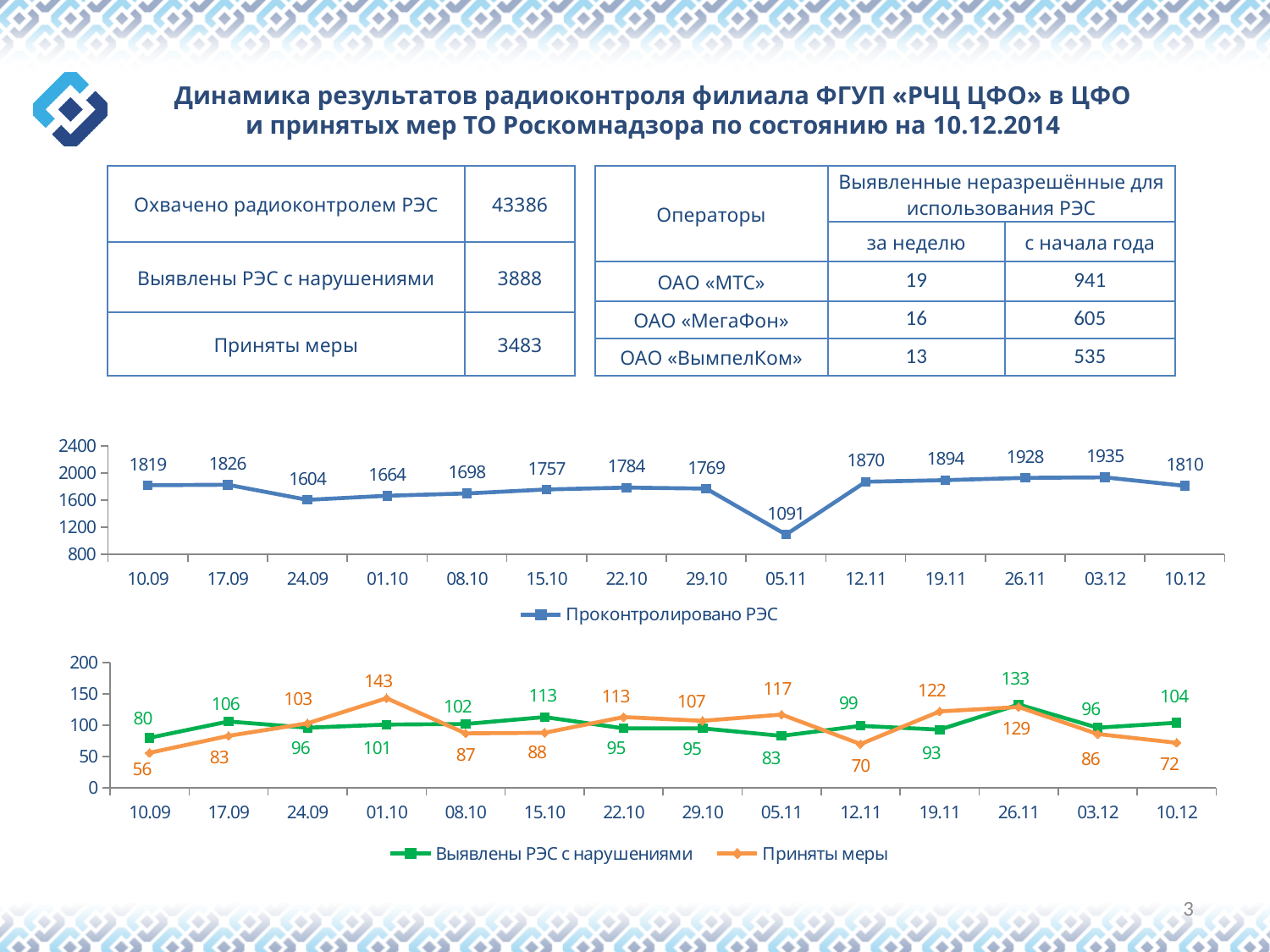
In the bottom chart, which is larger for 12.11: Выявлены РЭС с нарушениями or Приняты меры? Выявлены РЭС с нарушениями In the top chart (Проконтролировано РЭС), what is the difference between the values for 03.12 and 10.12? 125 How many series does the legend of the bottom chart list? 2 In the bottom chart, what is the value of Выявлены РЭС с нарушениями for 26.11? 133 In the top chart (Проконтролировано РЭС), which date has the highest value? 03.12 In the top chart (Проконтролировано РЭС), what is the value for 05.11? 1091 What type of chart is the top chart (Проконтролировано РЭС)? Line chart In the bottom chart, which date has the lowest value for Приняты меры? 10.09 In the top chart (Проконтролировано РЭС), which date has the lowest value? 05.11 In the bottom chart, what is the difference between Приняты меры and Выявлены РЭС с нарушениями for 19.11? 29 In the top chart (Проконтролировано РЭС), how many data points are plotted? 14 In the bottom chart, what is the value of Приняты меры for 01.10? 143